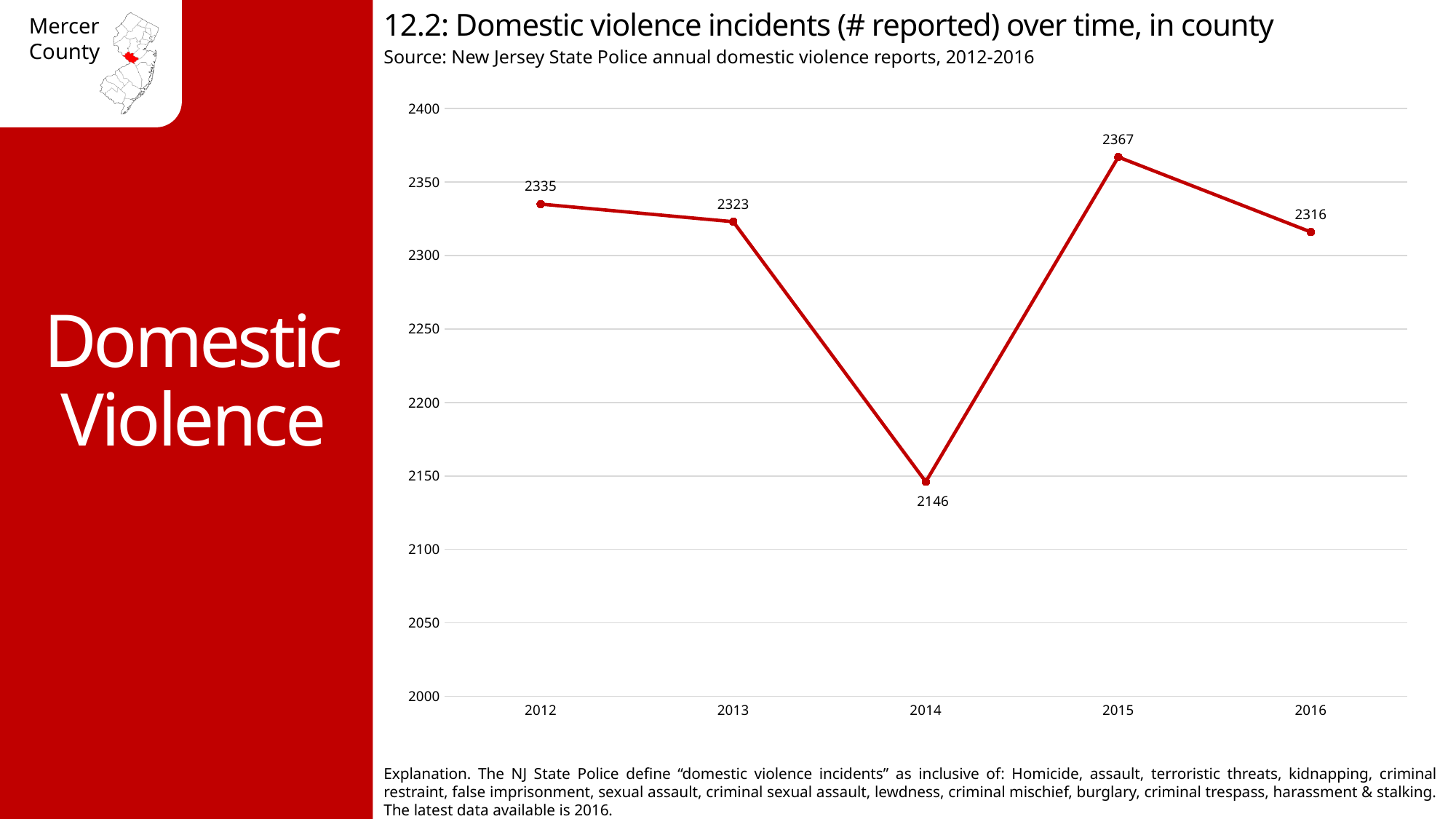
What is the number of reported domestic violence incidents for 2014? 2146 Did the number of reported incidents rise or fall from 2015 to 2016? fall How many domestic violence incidents were reported in 2012? 2335 Is the value for 2014 greater or less than 2200? less Which year had more reported incidents, 2012 or 2016? 2012 By how much did the number of incidents fall from 2012 to 2013? 12 Which year has the lowest number of reported domestic violence incidents? 2014 Which year has the highest number of reported domestic violence incidents? 2015 What is the difference between the number of incidents in 2015 and in 2014? 221 What kind of chart is shown on the slide? line chart How many years are plotted on the chart? 5 What value is shown for 2016? 2316